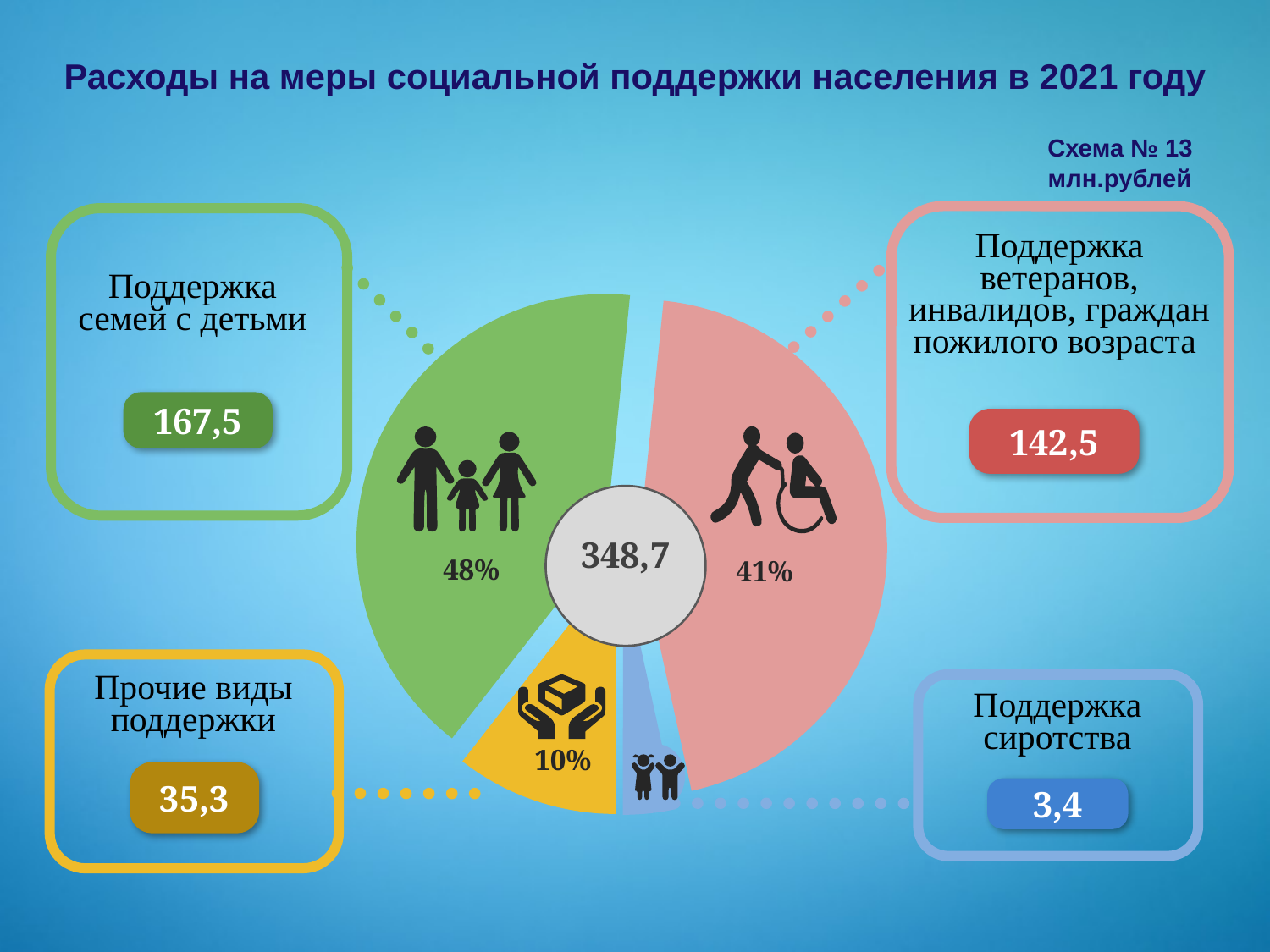
What kind of chart is shown on the slide? pie chart What share of the pie does "Прочие виды поддержки" take? 10% What is the value for "Поддержка ветеранов, инвалидов, граждан пожилого возраста"? 142,5 What is the total value shown in the centre of the pie chart? 348,7 How many categories does the pie chart show? 4 What is the value for "Поддержка сиротства"? 3,4 What is the value for "Прочие виды поддержки"? 35,3 Which category has the largest value? Поддержка семей с детьми What share of the pie does "Поддержка семей с детьми" take? 48% What is the value for "Поддержка семей с детьми"? 167,5 Which category has the smallest value? Поддержка сиротства What unit is stated for the values on the slide? млн.рублей